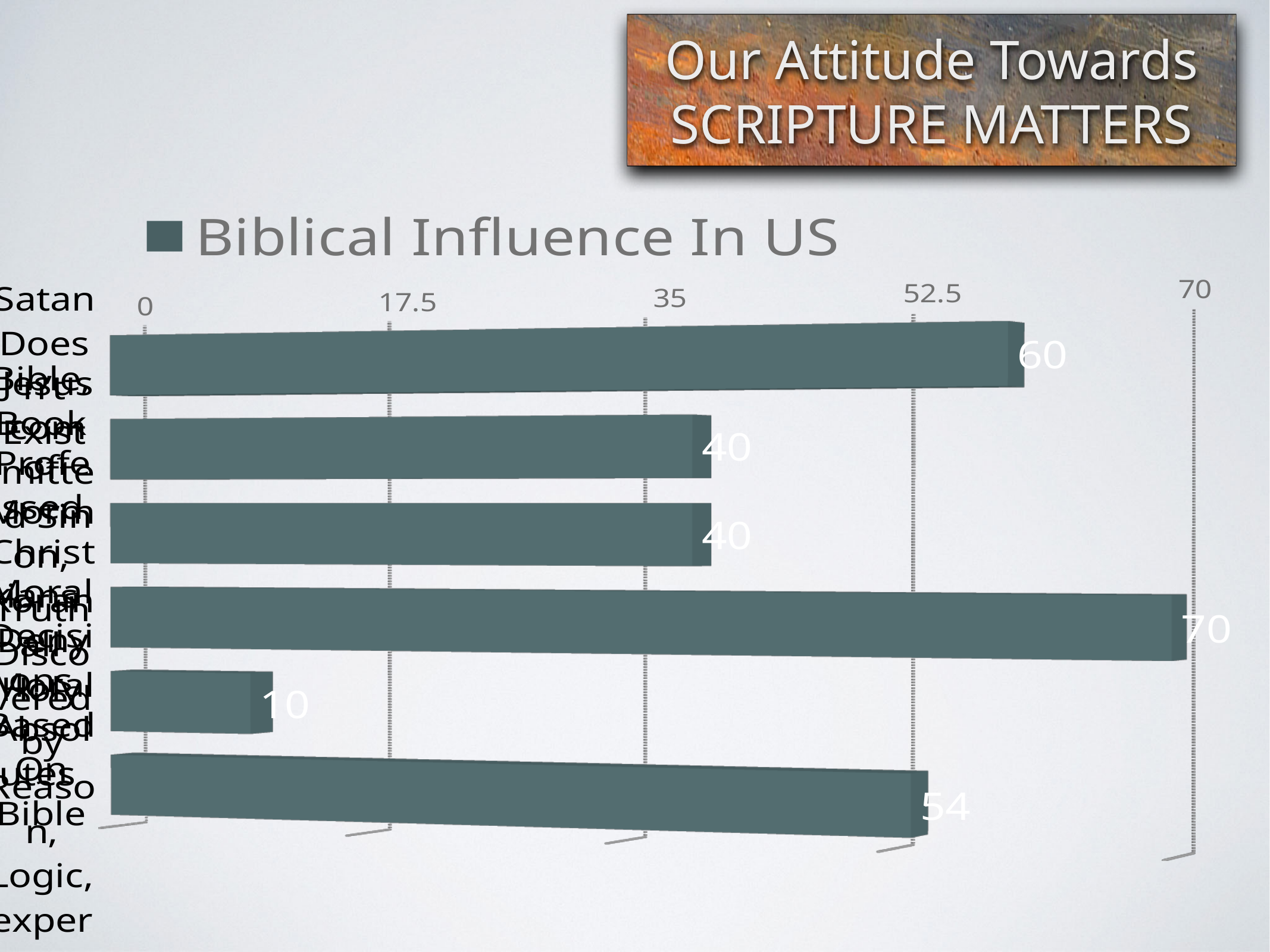
Which is larger, the value of the topmost bar or the value of the bottom bar? the topmost bar How many series does the legend list? 1 What is the value of the topmost bar in the chart? 60 What is the value of the fifth bar from the top? 10 What is the name of the series shown in the legend? Biblical Influence In US What is the value of the bottom bar in the chart? 54 What is the value of the fourth bar from the top? 70 How many bars does the chart show? 6 What is the difference between the largest bar value (70) and the smallest bar value (10)? 60 What is the highest value shown on any bar in the chart? 70 What is the lowest value shown on any bar in the chart? 10 What kind of chart is shown on the slide? bar chart